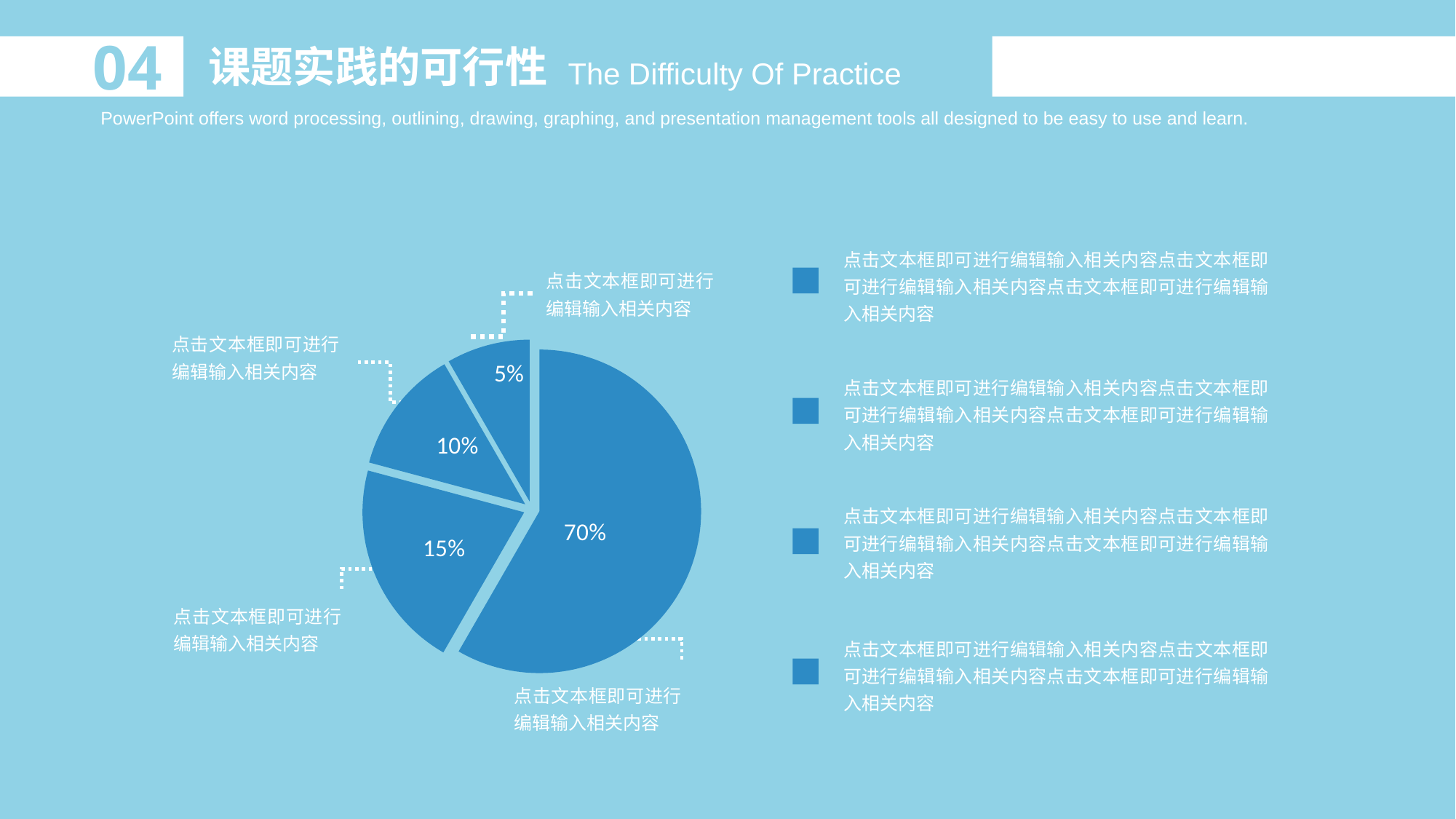
What is the difference between the 15% slice and the 10% slice in the pie chart? 5% What is the English subtitle of the slide containing the pie chart? The Difficulty Of Practice What is the value of the largest slice in the pie chart? 70% What kind of chart is shown on the slide? pie chart What is the value of the smallest slice in the pie chart? 5% Which is larger in the pie chart, the slice labelled 10% or the slice labelled 15%? 15% What is the second-largest value shown in the pie chart? 15% Is the largest slice of the pie chart greater or less than 50%? greater How many slices does the pie chart have? 4 What is the difference between the largest slice and the smallest slice in the pie chart? 65% What is the section number shown at the top left of the slide? 04 What is the combined value of the three smallest slices in the pie chart? 30%